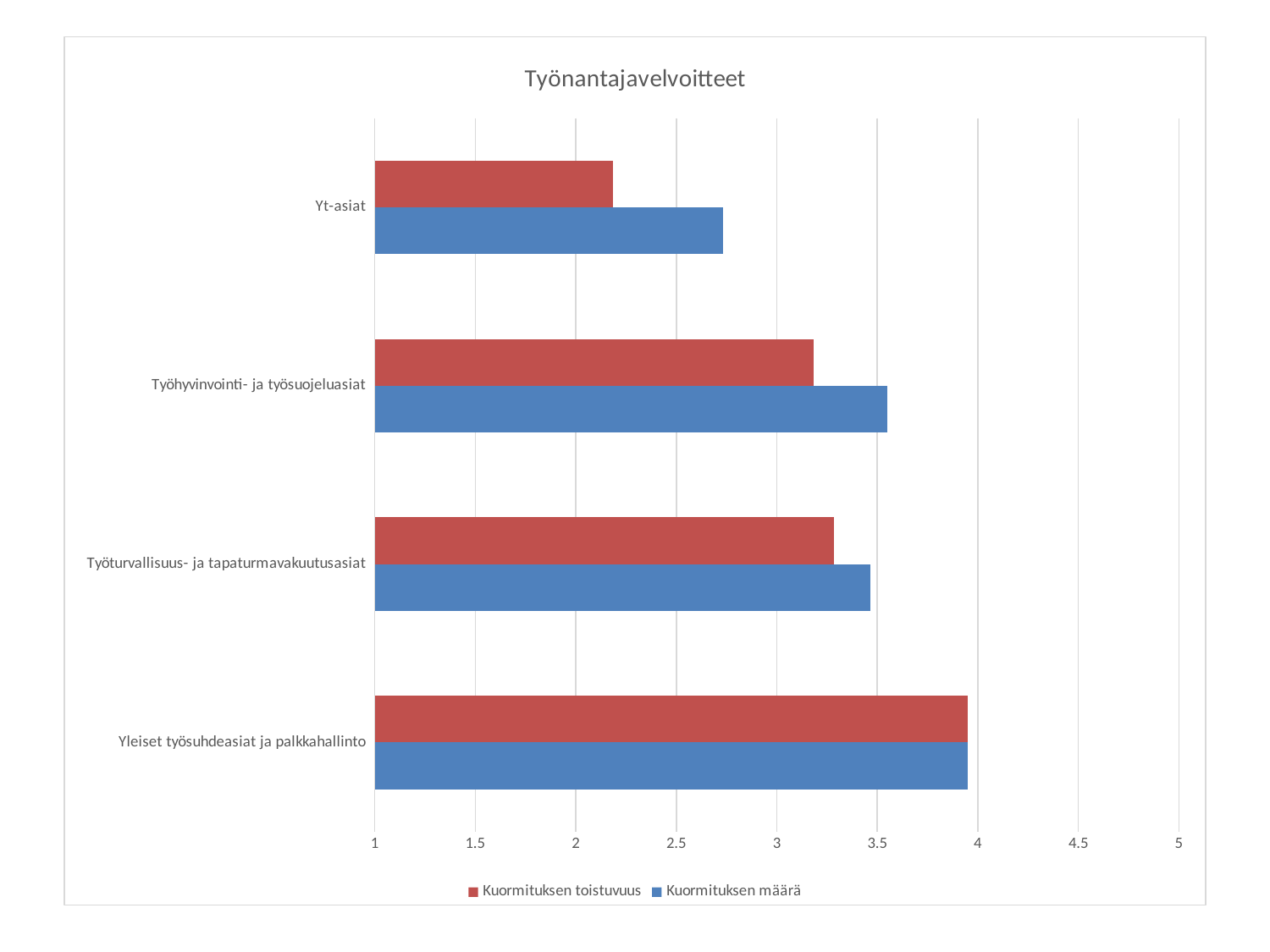
Is the Kuormituksen toistuvuus value for Yt-asiat greater or less than 2.5? less Is the Kuormituksen määrä value for Yleiset työsuhdeasiat ja palkkahallinto greater or less than 3.5? greater Is the Kuormituksen määrä value for Yt-asiat greater or less than 2.5? greater For Työhyvinvointi- ja työsuojeluasiat, which series has the larger value, Kuormituksen toistuvuus or Kuormituksen määrä? Kuormituksen määrä How many series does the legend list? 2 How many categories are shown on the chart? 4 Which category has the highest value for Kuormituksen määrä? Yleiset työsuhdeasiat ja palkkahallinto Which category has the lowest value for Kuormituksen määrä? Yt-asiat What is the title of the chart? Työnantajavelvoitteet Which category has the lowest value for Kuormituksen toistuvuus? Yt-asiat What kind of chart is shown on the slide? bar chart